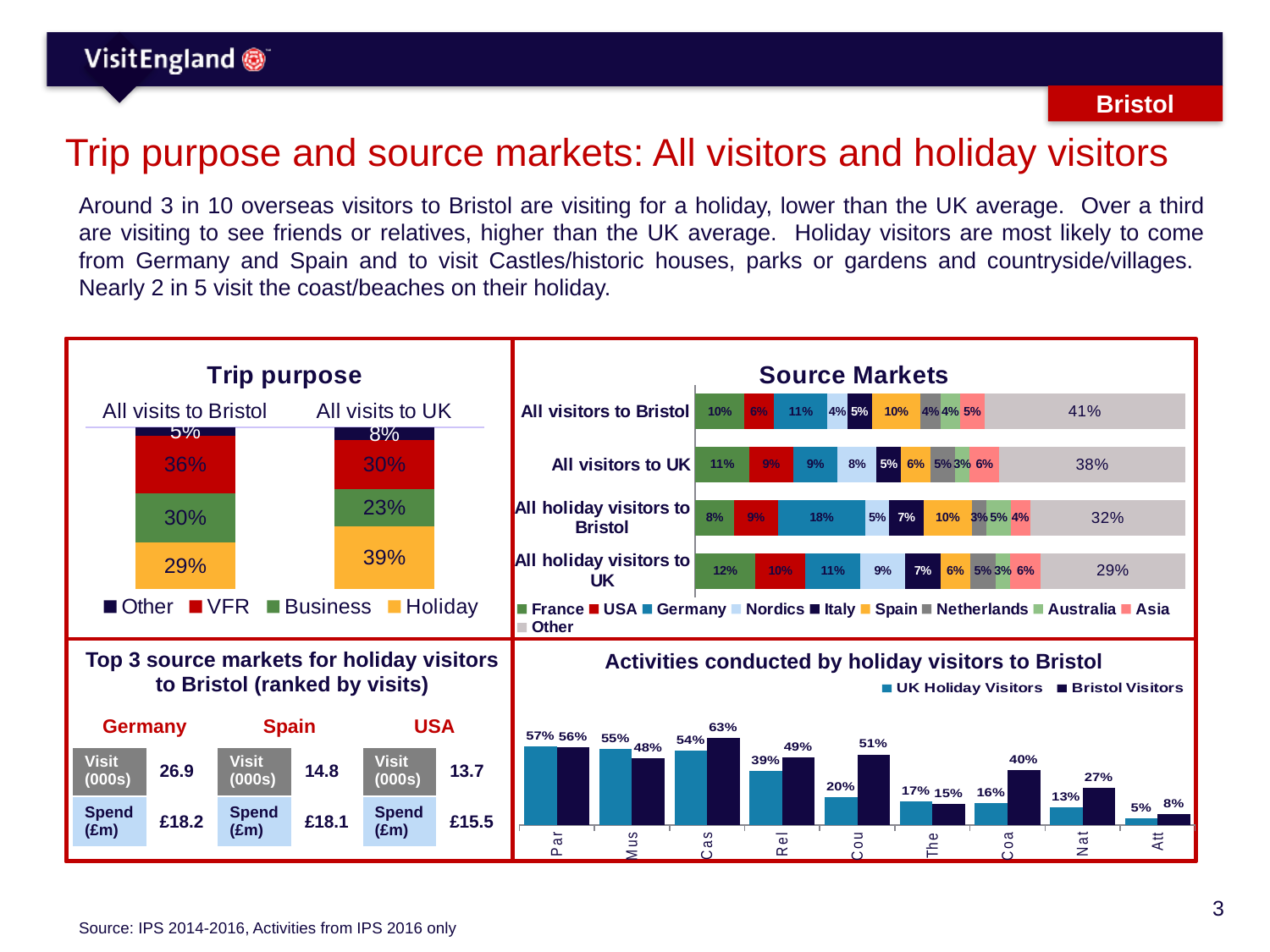
In the Activities conducted by holiday visitors to Bristol chart, which category has the lowest UK Holiday Visitors value? Att In the Source Markets chart, what share of all holiday visitors to Bristol come from Germany? 18% In the Activities conducted by holiday visitors to Bristol chart, what is the difference between the Bristol Visitors and UK Holiday Visitors values for the category labelled Cou? 31 percentage points In the Trip purpose chart, what share of all visits to Bristol are for a holiday? 29% In the Trip purpose chart, what is the difference between the Business share for all visits to Bristol and for all visits to the UK? 7 percentage points In the Trip purpose chart, what share of all visits to the UK are VFR? 30% How many series does the legend of the Source Markets chart list? 10 In the Source Markets chart, what share of all visitors to Bristol fall into the Other category? 41% In the Activities conducted by holiday visitors to Bristol chart, what is the Bristol Visitors value for the category labelled Cas? 63% In the Source Markets chart, which is larger: the Spain share for all holiday visitors to Bristol or for all holiday visitors to the UK? All holiday visitors to Bristol What kind of chart is the Activities conducted by holiday visitors to Bristol chart? Bar chart How many series does the legend of the Trip purpose chart list? 4